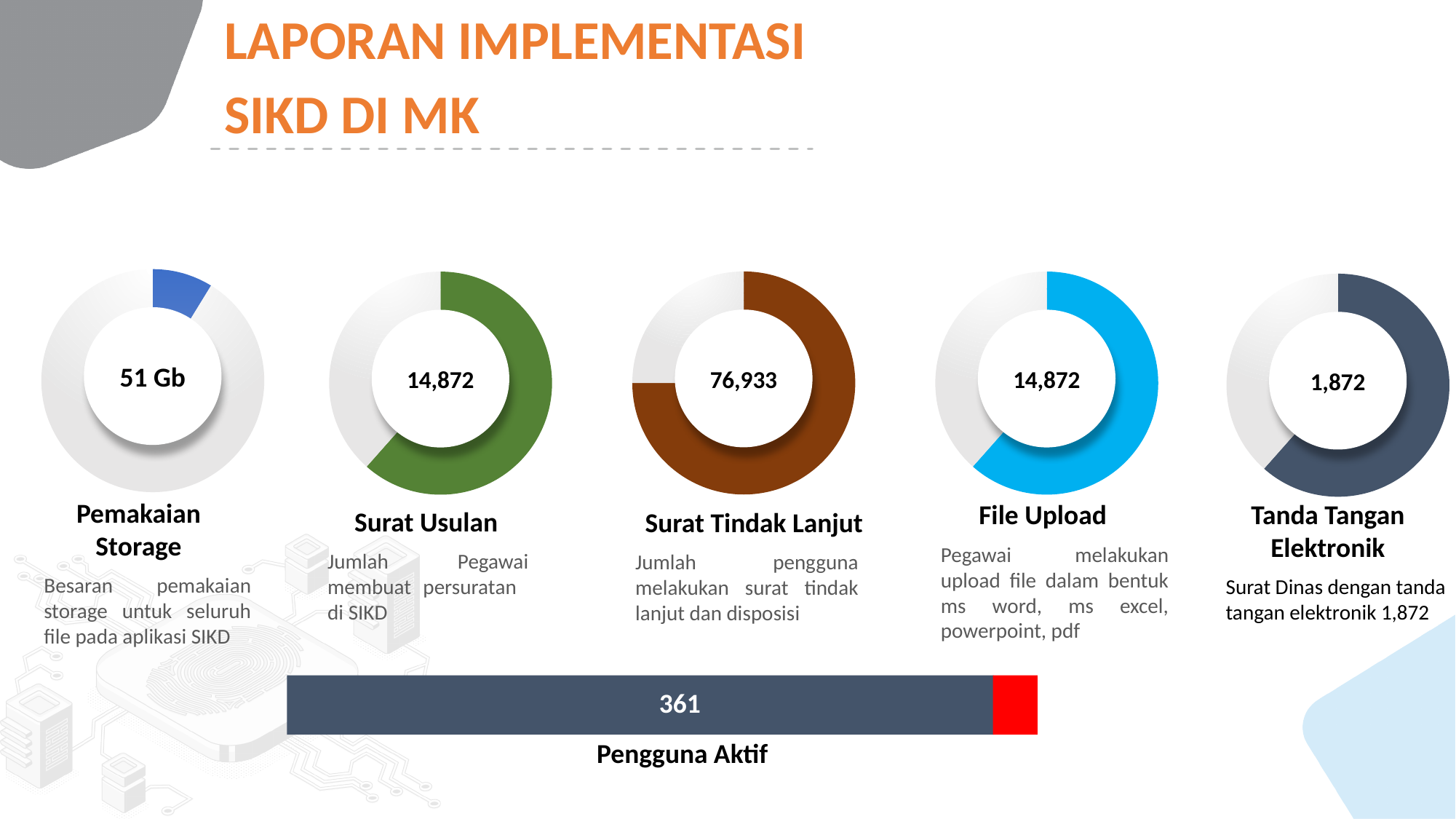
Which is larger, the Surat Tindak Lanjut value or the Tanda Tangan Elektronik value? Surat Tindak Lanjut What value is shown in the centre of the File Upload donut chart? 14,872 What is the difference between the File Upload value and the Tanda Tangan Elektronik value? 13,000 How many donut charts are shown on the slide? 5 What colour is the filled portion of the Surat Usulan donut chart? Green What is the difference between the Surat Tindak Lanjut value and the Tanda Tangan Elektronik value? 75,061 What value is shown in the centre of the Tanda Tangan Elektronik donut chart? 1,872 What value is printed on the Pengguna Aktif bar at the bottom of the slide? 361 What value is shown in the centre of the Pemakaian Storage donut chart? 51 Gb What value is shown in the centre of the Surat Usulan donut chart? 14,872 What value is shown in the centre of the Surat Tindak Lanjut donut chart? 76,933 What kind of chart is used for Surat Usulan, Surat Tindak Lanjut and File Upload? Donut chart